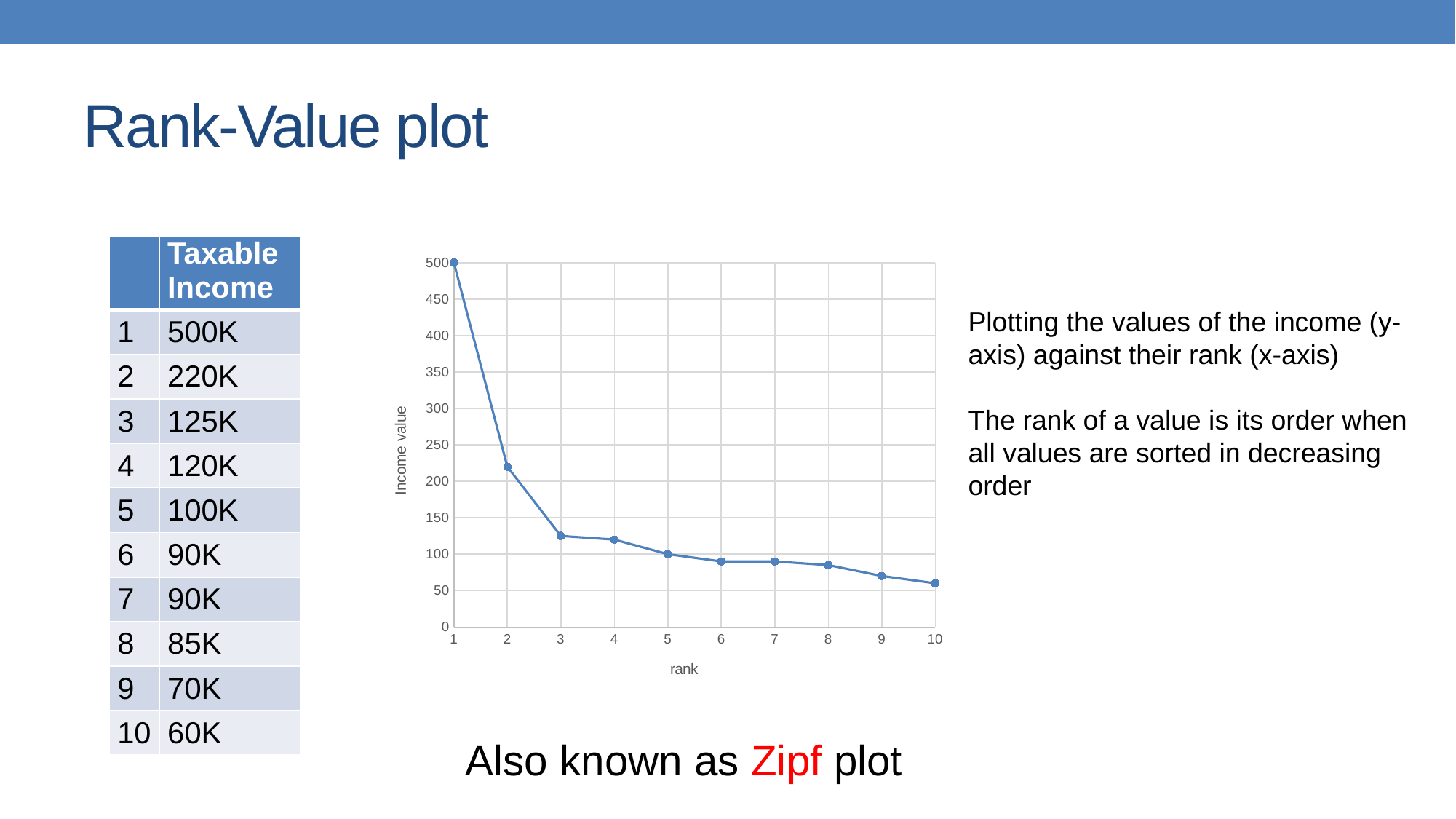
What is the label of the y axis on the chart? Income value Is the income value at rank 3 greater or less than 150? less Which rank has the highest income value on the chart? 1 Is the income value at rank 9 greater or less than 50? greater What is the income value plotted at rank 1? 500 How many data points are plotted on the chart? 10 What kind of chart is shown on the slide? line chart Do the income values rise or fall as rank increases along the x axis? fall Which rank has the lowest income value on the chart? 10 Which has a larger income value on the chart, rank 2 or rank 3? rank 2 Is the income value at rank 2 greater or less than 200? greater What is the income value plotted at rank 5? 100